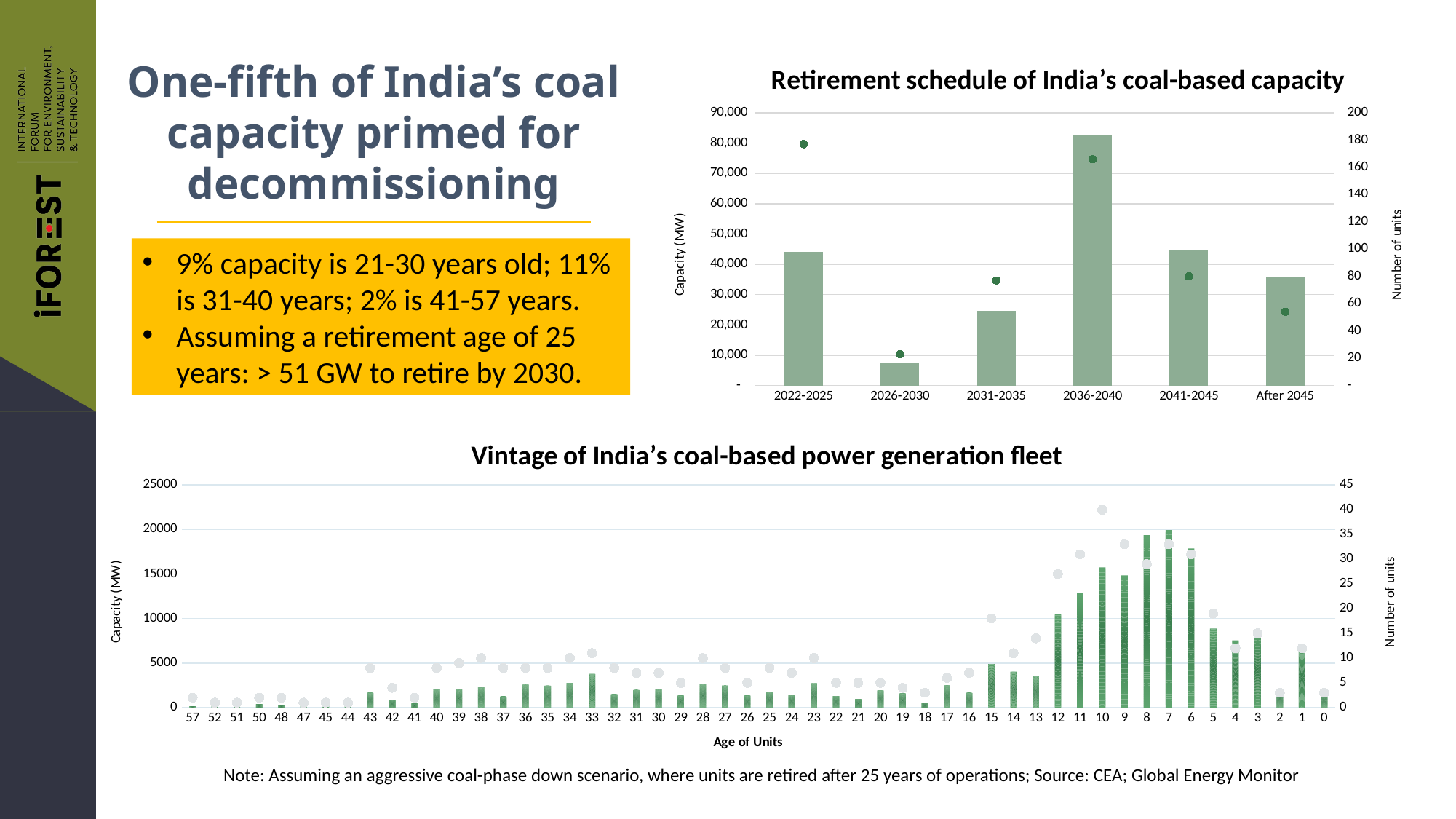
In the 'Retirement schedule of India's coal-based capacity' chart, which period has the lowest capacity bar? 2026-2030 In the 'Vintage of India's coal-based power generation fleet' chart, is the capacity bar for age 33 greater or less than 5000? less What is the x-axis title of the 'Vintage of India's coal-based power generation fleet' chart? Age of Units In the 'Retirement schedule of India's coal-based capacity' chart, which capacity bar is taller, 2041-2045 or After 2045? 2041-2045 In the 'Retirement schedule of India's coal-based capacity' chart, is the capacity bar for 2022-2025 greater or less than 40,000? greater In the 'Vintage of India's coal-based power generation fleet' chart, which capacity bar is taller, age 9 or age 15? age 9 In the 'Retirement schedule of India's coal-based capacity' chart, which period has the highest capacity bar? 2036-2040 In the 'Retirement schedule of India's coal-based capacity' chart, is the capacity bar for 2031-2035 greater or less than 30,000? less What is the label of the left vertical axis in the 'Retirement schedule of India's coal-based capacity' chart? Capacity (MW) How many retirement periods are shown on the x axis of the 'Retirement schedule of India's coal-based capacity' chart? 6